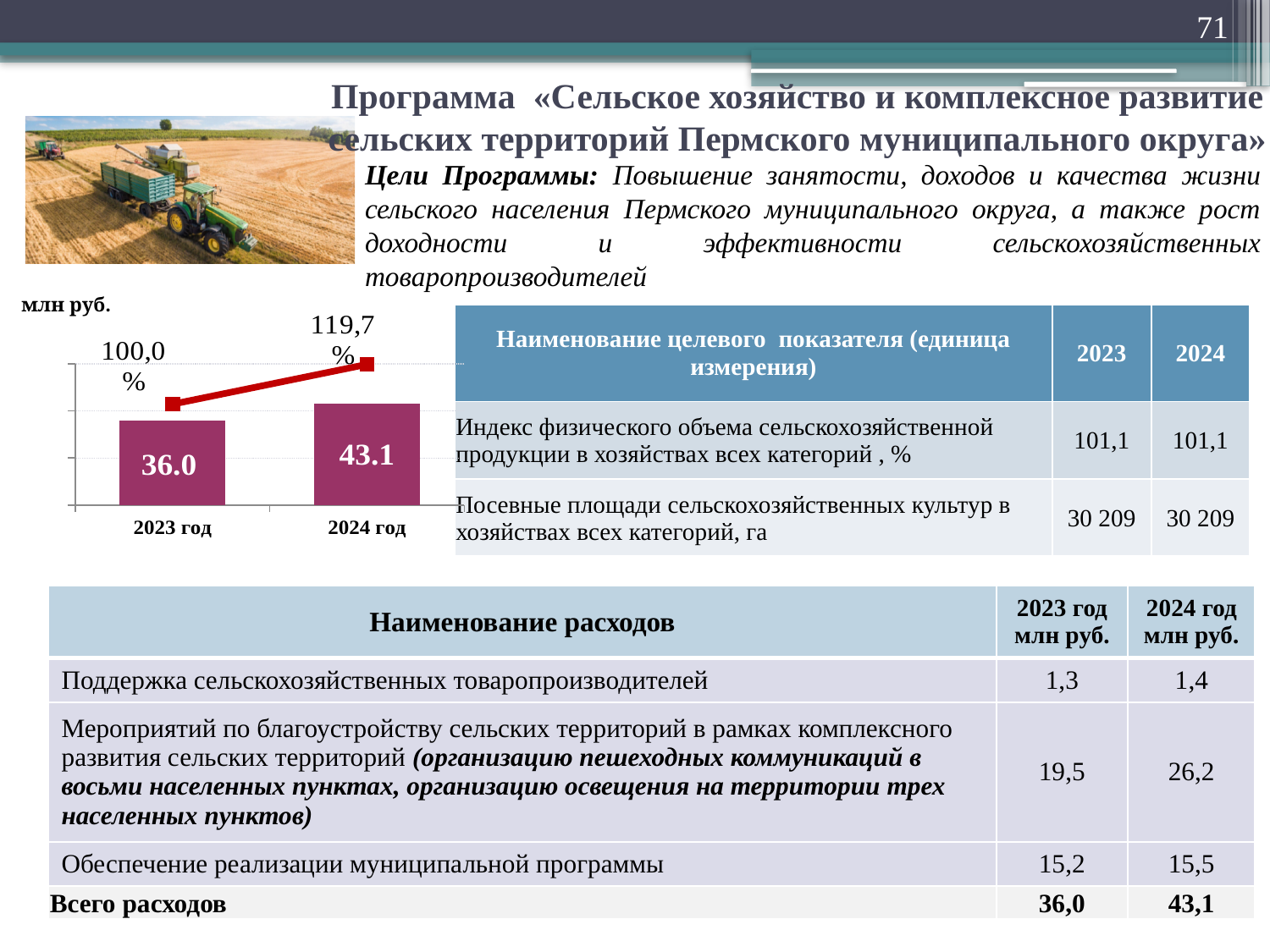
By how much does the bar value for 2024 год exceed the bar value for 2023 год? 7.1 What is the value of the bar for 2024 год in the chart? 43.1 How many years (categories) are shown on the x axis of the chart? 2 Do the bar values rise or fall from 2023 год to 2024 год? rise Which year has the higher bar in the chart? 2024 год What percentage is shown on the line for 2024 год in the chart? 119,7 % What percentage is shown on the line for 2023 год in the chart? 100,0 % Is the bar for 2024 год larger or smaller than the bar for 2023 год? larger What is the value of the bar for 2023 год in the chart? 36.0 Which year has the lower bar in the chart? 2023 год What is the difference between the line percentages for 2024 год and 2023 год? 19,7 % What kind of chart is shown on the slide? bar chart with a line